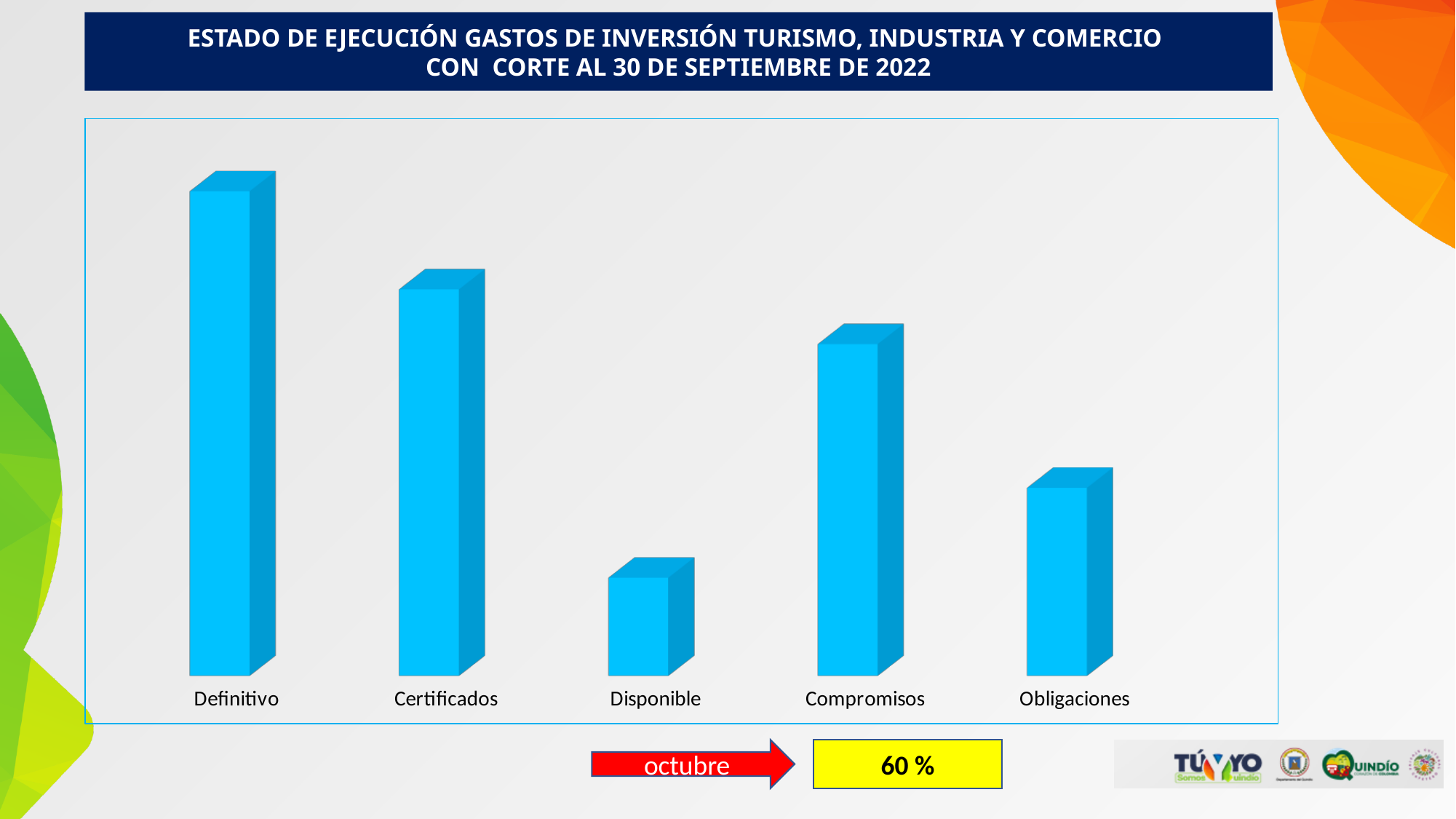
Which is larger, the bar for Certificados or the bar for Compromisos? Certificados What is the second-tallest bar in the chart? Certificados Which is larger, the bar for Definitivo or the bar for Certificados? Definitivo What colour are the bars in the chart? Blue Which category has the shortest bar? Disponible Which is larger, the bar for Obligaciones or the bar for Disponible? Obligaciones How many categories are shown on the x axis of the chart? 5 What kind of chart is shown on the slide? Bar chart Which category has the tallest bar? Definitivo What is the label of the fourth category from the left? Compromisos